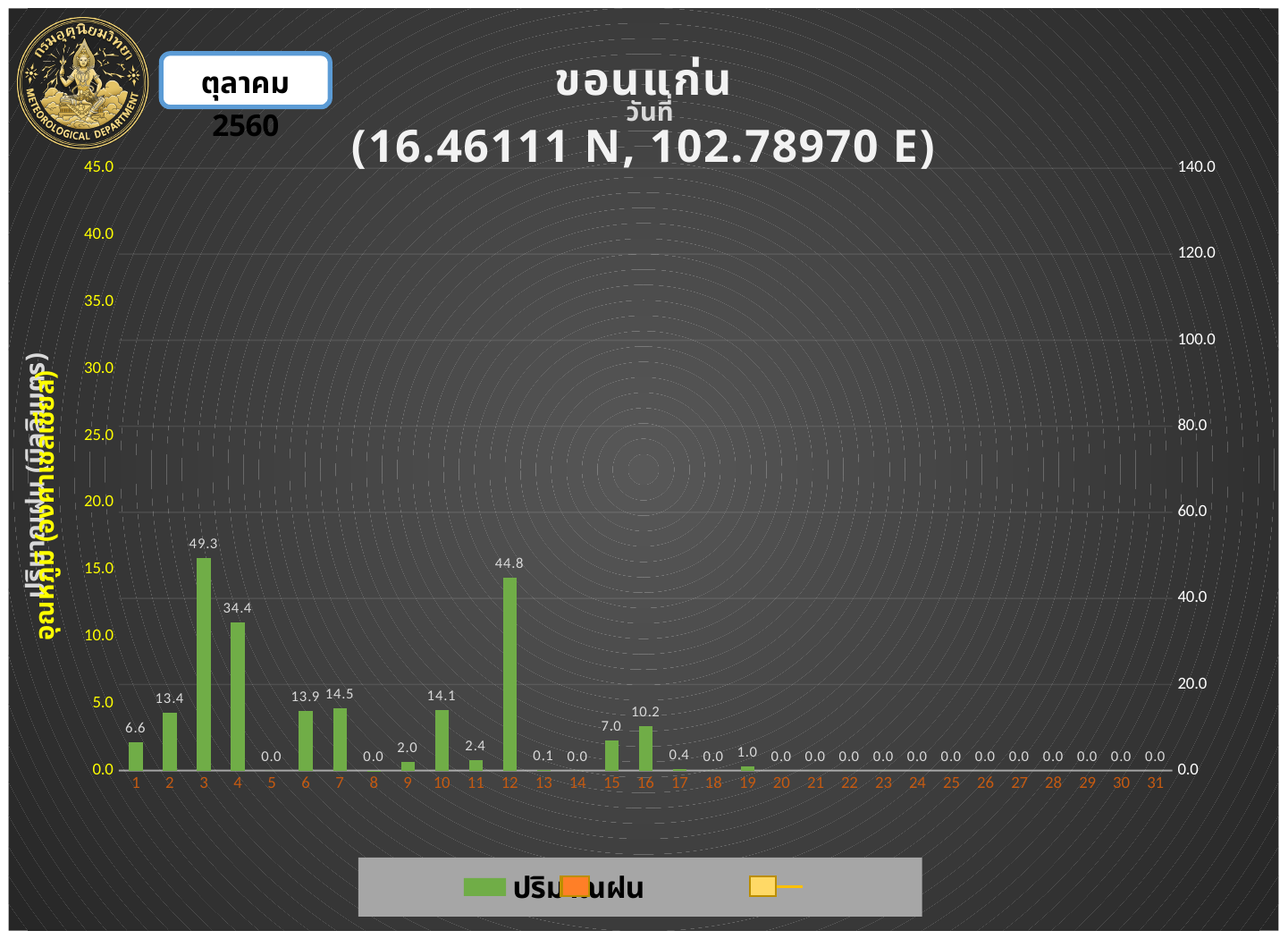
What is the value shown for day 1? 6.6 What kind of chart is shown on the slide? bar chart What is the value shown for day 16? 10.2 What is the rainfall value shown for day 3? 49.3 What coordinates are given in the chart title? 16.46111 N, 102.78970 E What is the rainfall value shown for day 12? 44.8 Which is larger, the value for day 15 or the value for day 16? day 16 Which is larger, the value for day 4 or the value for day 10? day 4 What is the difference between the values for day 3 and day 12? 4.5 Which day has the highest rainfall value? 3 What is the difference between the values for day 7 and day 6? 0.6 How many days (categories) are shown on the x axis? 31